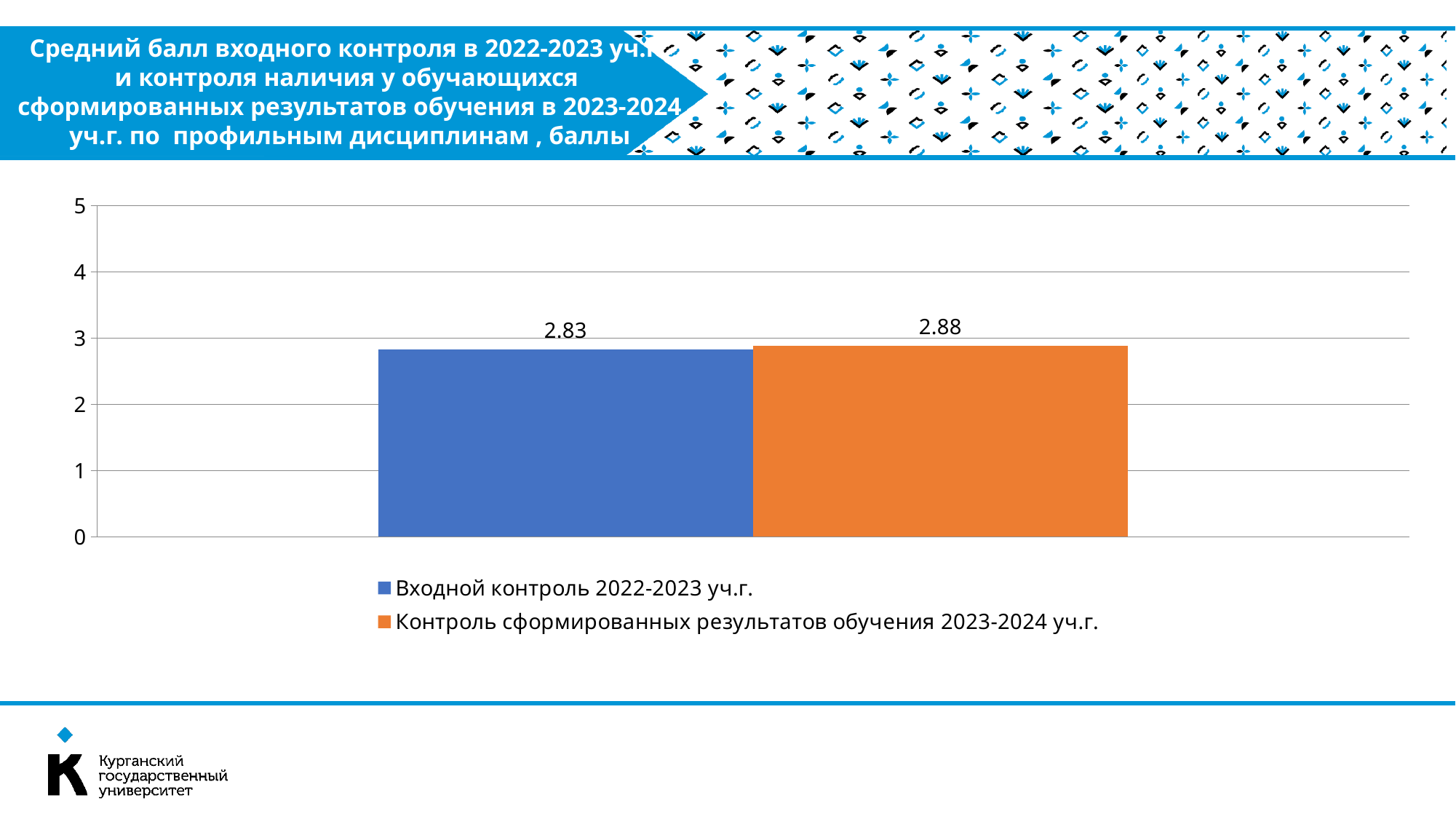
Is the value for "Контроль сформированных результатов обучения 2023-2024 уч.г." greater or less than 2? greater Which series has the lower value? Входной контроль 2022-2023 уч.г. Is the value for "Входной контроль 2022-2023 уч.г." greater or less than 3? less Is the value for "Входной контроль 2022-2023 уч.г." larger or smaller than the value for "Контроль сформированных результатов обучения 2023-2024 уч.г."? smaller What is the value for "Контроль сформированных результатов обучения 2023-2024 уч.г."? 2.88 Which series has the higher value? Контроль сформированных результатов обучения 2023-2024 уч.г. What is the difference between the value for "Контроль сформированных результатов обучения 2023-2024 уч.г." and the value for "Входной контроль 2022-2023 уч.г."? 0.05 How many series does the legend list? 2 What is the value for "Входной контроль 2022-2023 уч.г."? 2.83 What colour is the bar for "Контроль сформированных результатов обучения 2023-2024 уч.г."? orange What kind of chart is shown on the slide? bar chart How many bars are plotted on the chart? 2